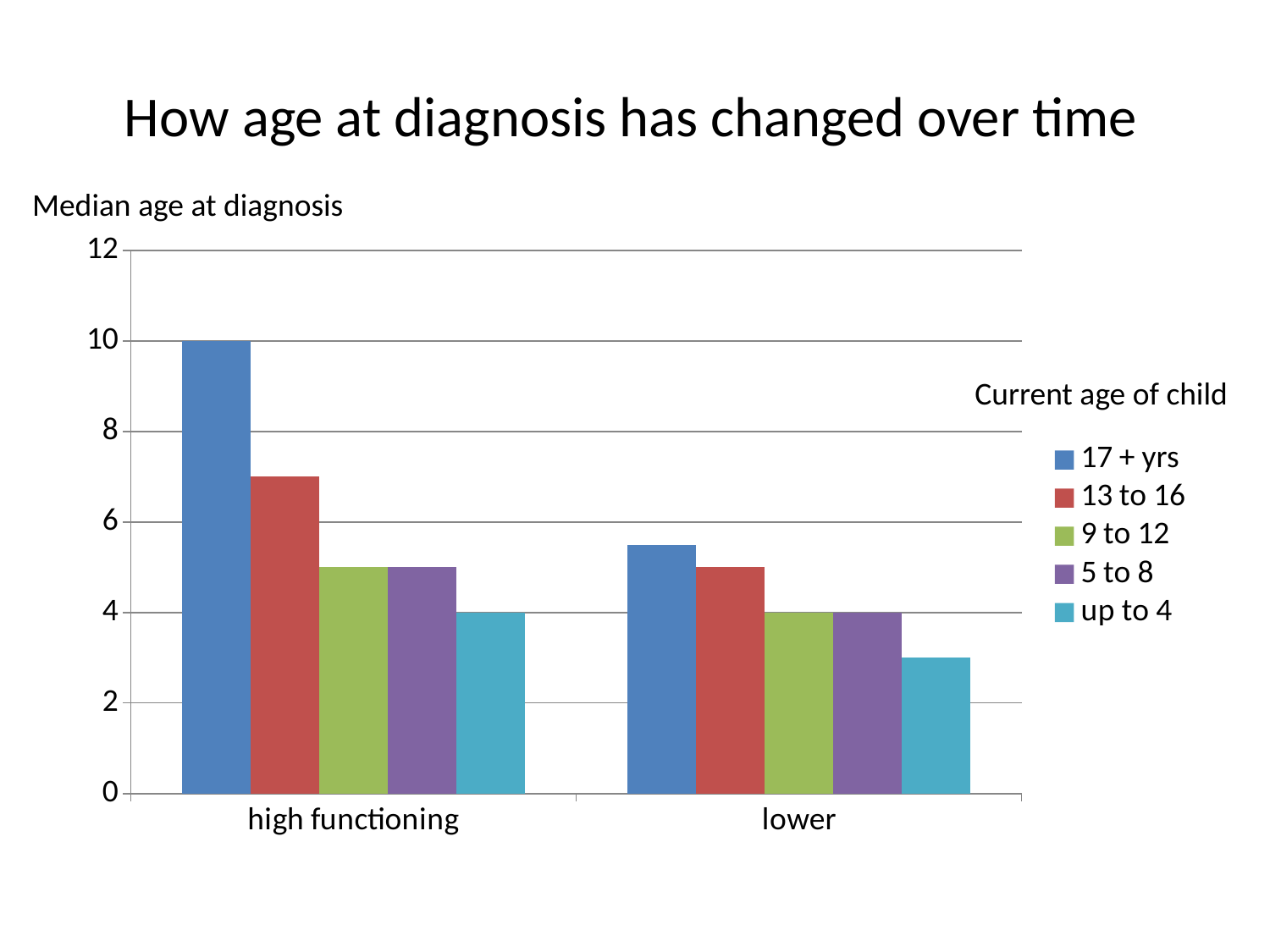
What is the median age at diagnosis for the 9 to 12 group in the lower category? 4 Is the value for 13 to 16 in the high functioning category greater or less than 6? greater What is the median age at diagnosis for the 17 + yrs group in the high functioning category? 10 Which current-age group has the highest median age at diagnosis in the high functioning category? 17 + yrs Is the value for up to 4 in the lower category greater or less than 4? less How many series does the legend list? 5 Which current-age group has the lowest median age at diagnosis in the lower category? up to 4 What is the title of the legend? Current age of child What is the median age at diagnosis for the up to 4 group in the high functioning category? 4 What is the difference between the 17 + yrs and up to 4 values in the high functioning category? 6 Is the 17 + yrs value larger in the high functioning category or the lower category? high functioning What kind of chart is shown on the slide? bar chart